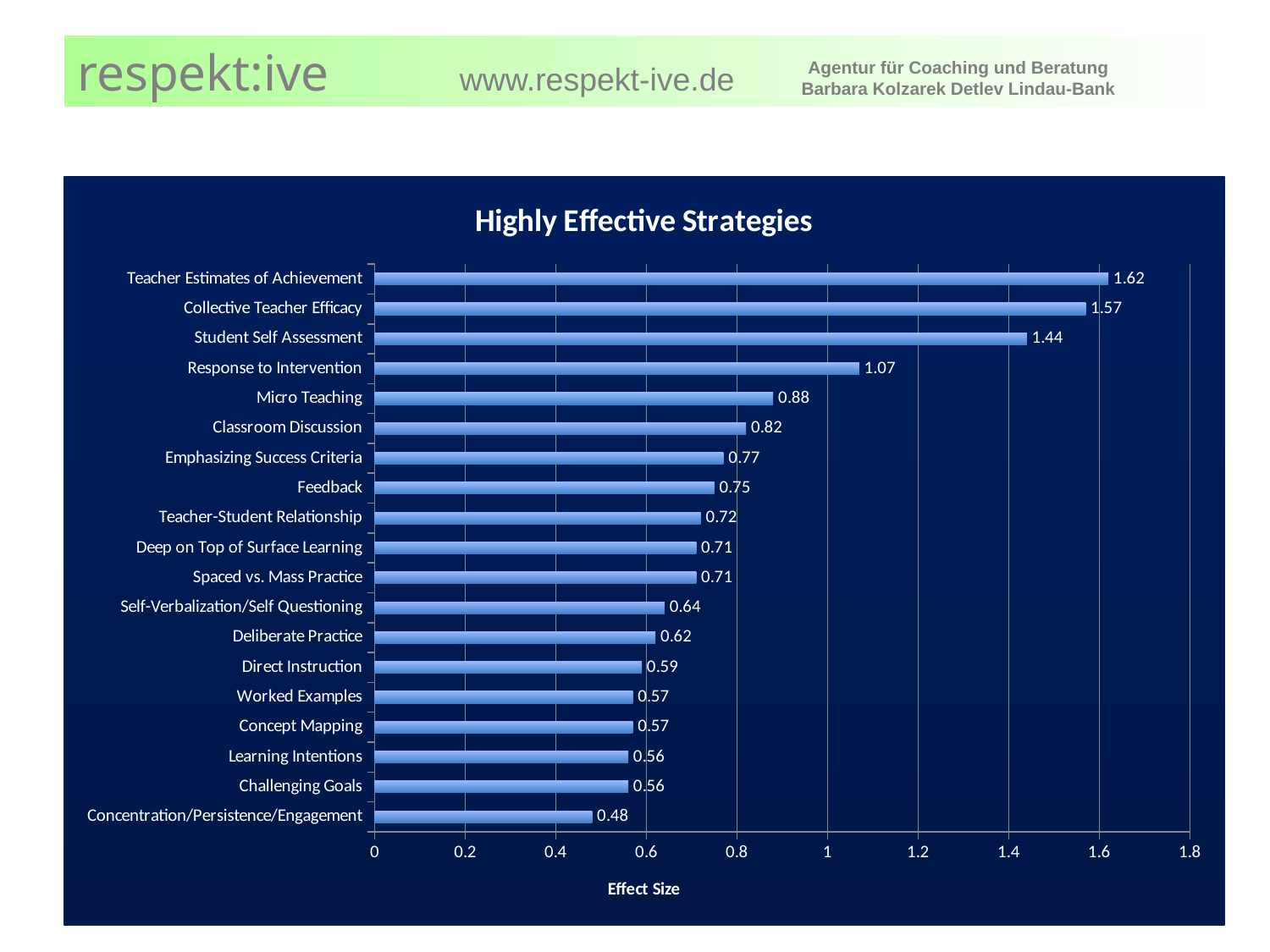
How many strategies are shown in the chart? 19 Which strategy has the lowest effect size? Concentration/Persistence/Engagement What is the effect size for Student Self Assessment? 1.44 Which strategy has the highest effect size? Teacher Estimates of Achievement What is the effect size for Micro Teaching? 0.88 Is the effect size for Response to Intervention greater or less than 1? greater What kind of chart is shown on the slide? Bar chart What is the title of the chart? Highly Effective Strategies What is the difference in effect size between Teacher Estimates of Achievement and Collective Teacher Efficacy? 0.05 Which has a larger effect size, Classroom Discussion or Direct Instruction? Classroom Discussion What is the difference in effect size between Response to Intervention and Feedback? 0.32 What is the effect size for Deliberate Practice? 0.62